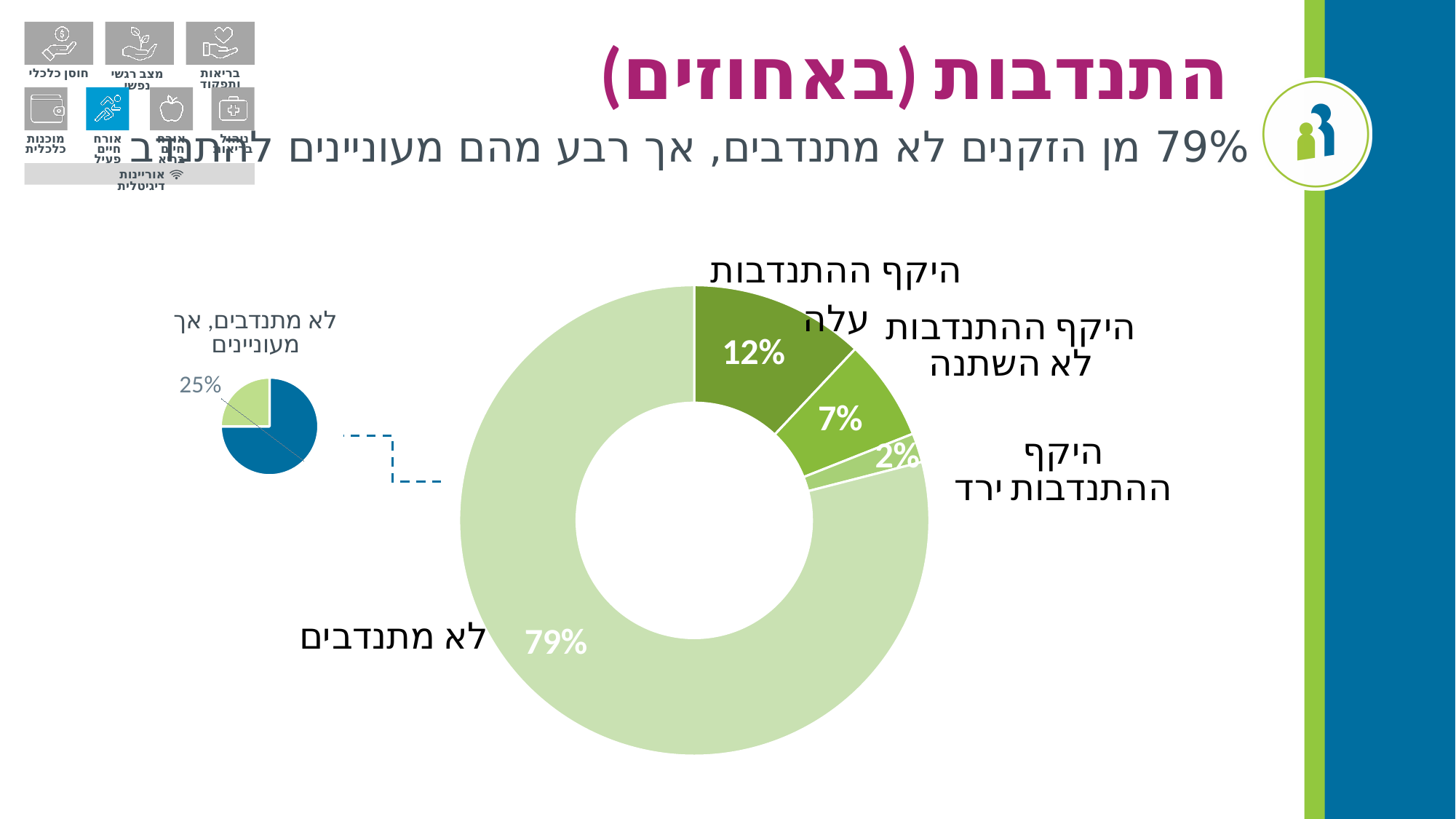
In the large donut chart, which segment has the largest share? לא מתנדבים In the large donut chart, what percentage is shown for the segment labelled "היקף ההתנדבות עלה"? 12% In the large donut chart, what percentage is shown for the segment labelled "היקף ההתנדבות ירד"? 2% In the large donut chart, which segment has the smallest share? היקף ההתנדבות ירד In the large donut chart, what is the difference in percentage points between "היקף ההתנדבות עלה" and "היקף ההתנדבות לא השתנה"? 5 In the large donut chart, what percentage is shown for the segment labelled "לא מתנדבים"? 79% In the large donut chart, what percentage is shown for the segment labelled "היקף ההתנדבות לא השתנה"? 7% How many segments does the large donut chart have? 4 What kind of chart is the large chart in the centre of the slide? Donut chart In the small pie chart on the left, what percentage is shown for the segment labelled "לא מתנדבים, אך מעוניינים"? 25% In the large donut chart, which segment is larger: "היקף ההתנדבות עלה" or "היקף ההתנדבות ירד"? היקף ההתנדבות עלה In the small pie chart on the left, what colour is the segment labelled "לא מתנדבים, אך מעוניינים"? Light green